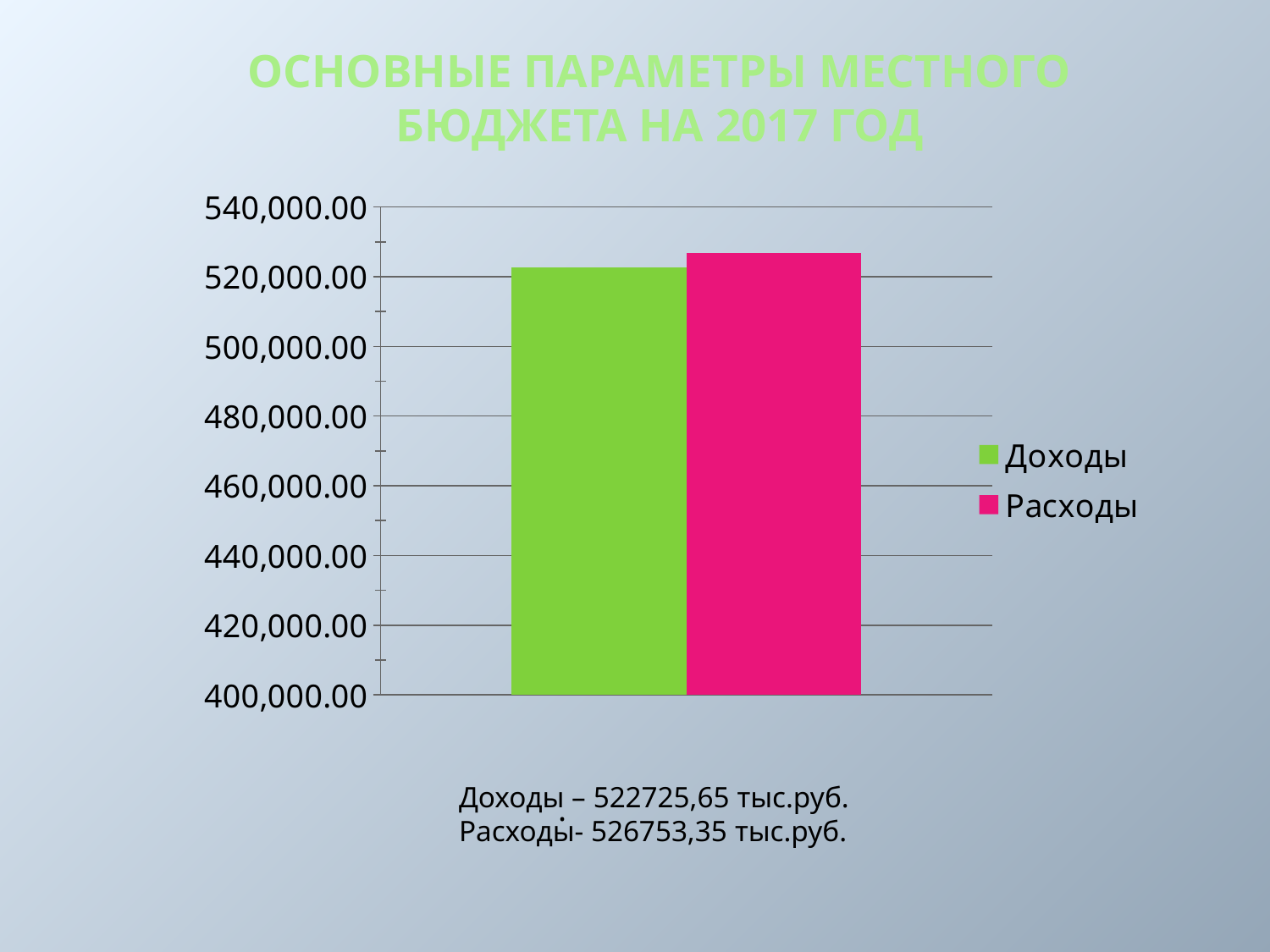
Is the value for Расходы greater or less than 520,000.00? greater Is the value for Доходы greater or less than 540,000.00? less Which series has the lowest bar in the chart? Доходы What is the title of the slide? ОСНОВНЫЕ ПАРАМЕТРЫ МЕСТНОГО БЮДЖЕТА НА 2017 ГОД What is the difference between Расходы and Доходы? 4027,70 тыс.руб. What kind of chart is shown on the slide? bar chart How many series does the legend list? 2 What is the value for Расходы shown on the slide? 526753,35 тыс.руб. How many bars are plotted in the chart? 2 Which series has the higher value, Доходы or Расходы? Расходы What is the value for Доходы shown on the slide? 522725,65 тыс.руб. What colour is the bar for Доходы? green